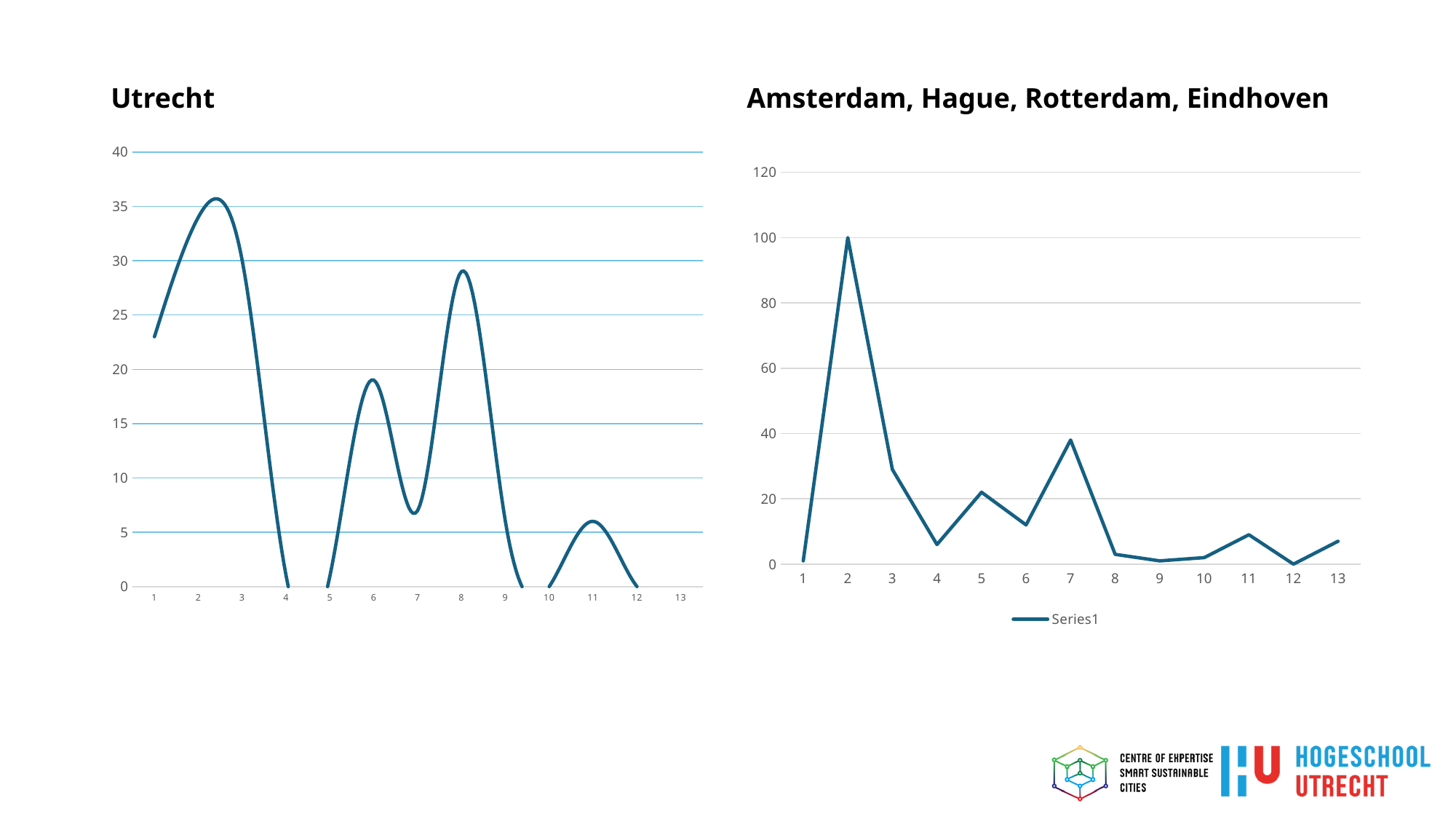
In the Amsterdam, Hague, Rotterdam, Eindhoven chart, is the value at category 3 greater or less than 40? less In the Utrecht chart, which is larger, the value at category 6 or the value at category 8? 8 How many series does the legend of the Amsterdam, Hague, Rotterdam, Eindhoven chart list? 1 In the Amsterdam, Hague, Rotterdam, Eindhoven chart, is the value at category 7 greater or less than 20? greater In the Amsterdam, Hague, Rotterdam, Eindhoven chart, what is the value at category 12? 0 What is the legend entry shown on the Amsterdam, Hague, Rotterdam, Eindhoven chart? Series1 What kind of chart is the Amsterdam, Hague, Rotterdam, Eindhoven chart? line chart What kind of chart is the Utrecht chart? line chart In the Amsterdam, Hague, Rotterdam, Eindhoven chart, what is the value at category 2? 100 In the Amsterdam, Hague, Rotterdam, Eindhoven chart, which x-axis category has the highest value? 2 In the Utrecht chart, is the value at category 6 greater or less than 15? greater